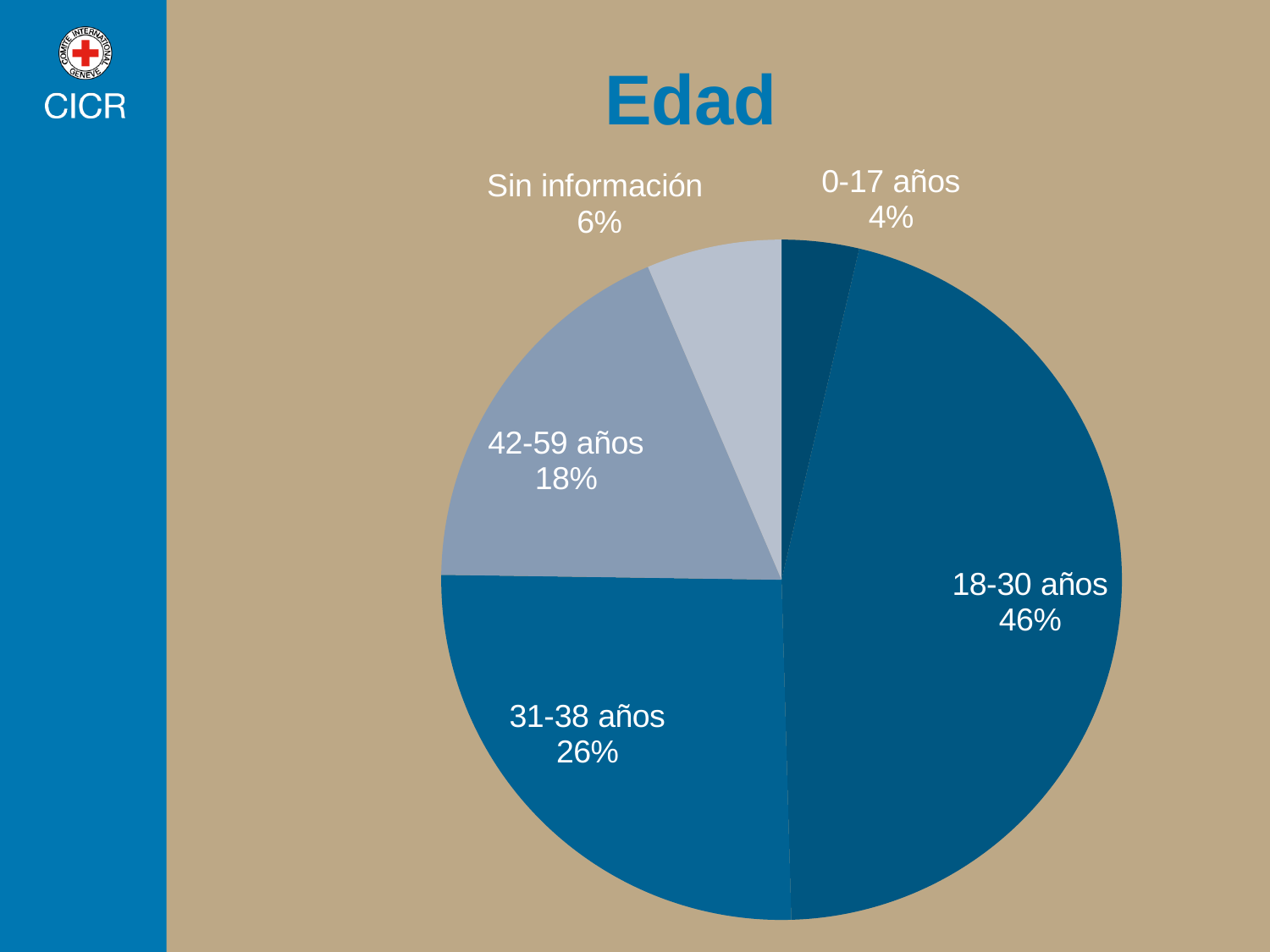
What type of chart is shown on the slide? pie chart What is the title of the chart? Edad Which category has the largest share of the pie? 18-30 años Which is larger, the share for 42-59 años or the share for Sin información? 42-59 años What is the difference in percentage points between 18-30 años and 31-38 años? 20 What percentage is shown for Sin información? 6% How many slices does the pie chart have? 5 What percentage is shown for 0-17 años? 4% What percentage is shown for 42-59 años? 18% What percentage is shown for 31-38 años? 26% What share of the pie does the 18-30 años slice represent? 46% Which category has the smallest share of the pie? 0-17 años